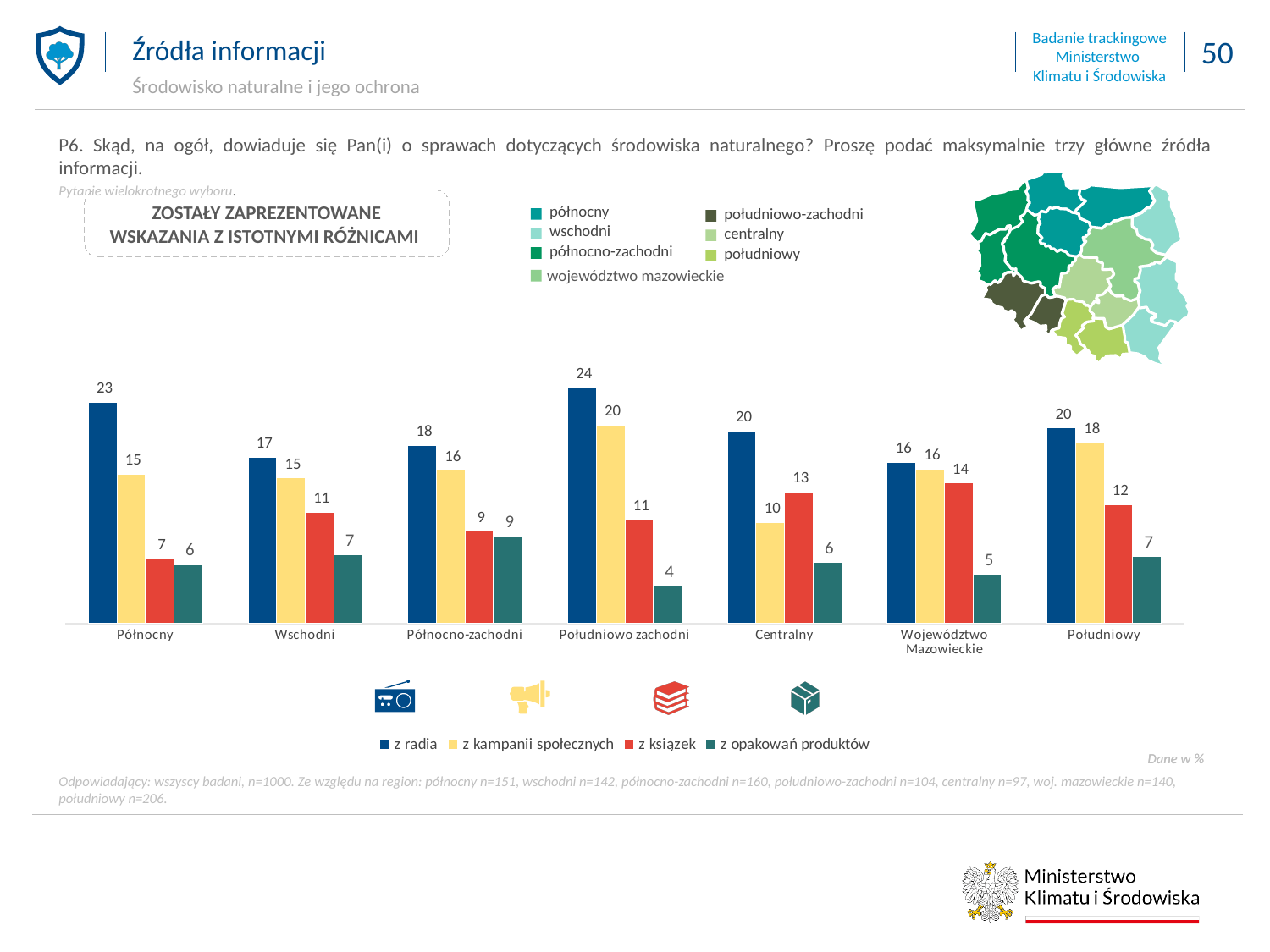
How many regions are shown on the x axis of the chart? 7 What is the value for 'z książek' in the Centralny region? 13 What is the value for 'z kampanii społecznych' in the Południowo zachodni region? 20 What is the value for 'z radia' in the Północny region? 23 How many series does the chart legend at the bottom list? 4 What is the difference between 'z radia' and 'z kampanii społecznych' in the Centralny region? 10 In the Wschodni region, which is larger: 'z radia' or 'z książek'? z radia Which region has the highest value for 'z radia'? Południowo zachodni What is the value for 'z opakowań produktów' in the Województwo Mazowieckie region? 5 Which colour represents 'z książek' in the chart? red Which region has the lowest value for 'z opakowań produktów'? Południowo zachodni What kind of chart is shown on the slide? bar chart